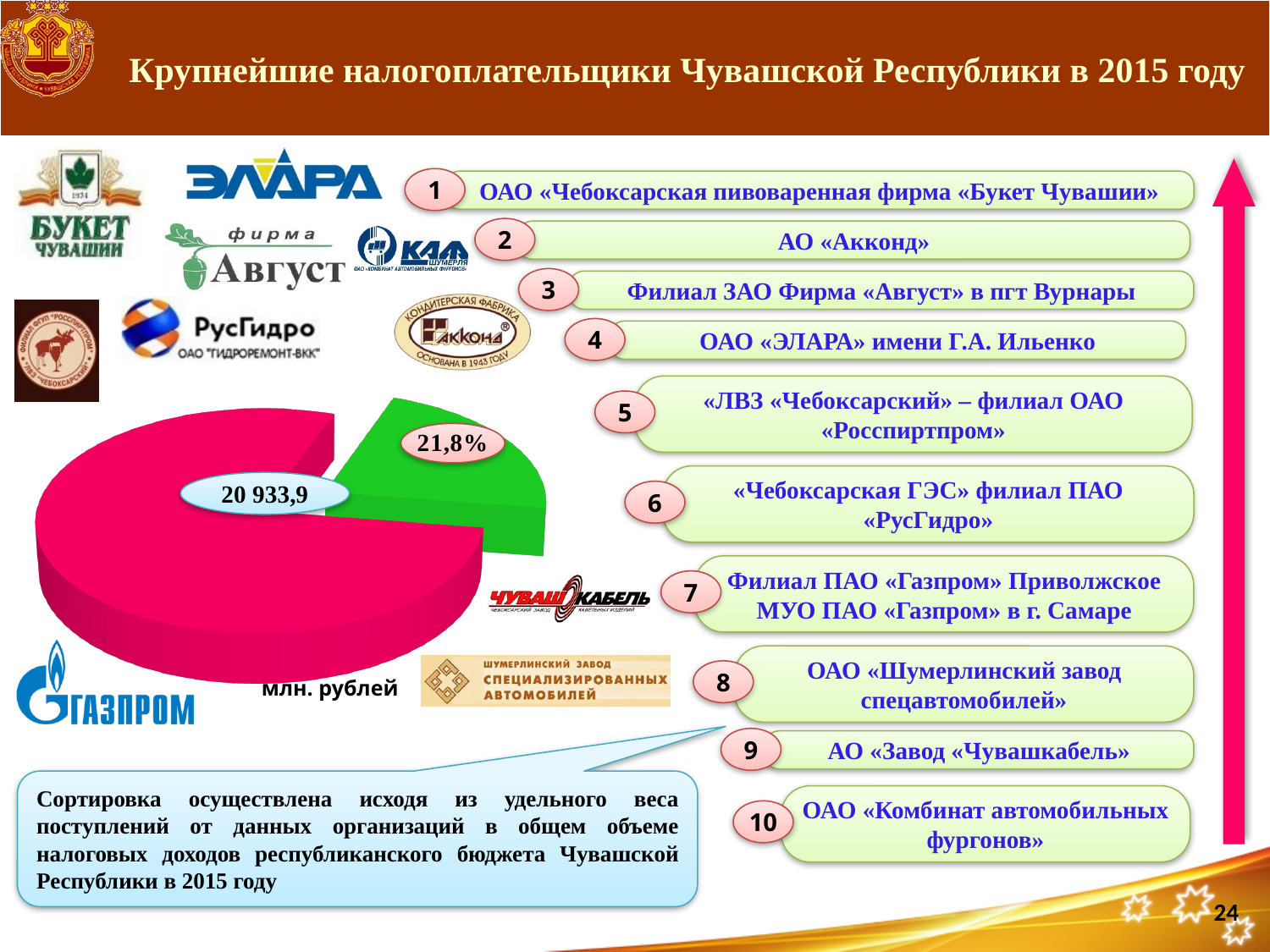
What colour is the largest slice of the pie chart? pink What percentage label is printed on the green slice of the pie chart? 21,8% Is the share of the green slice in the pie chart greater or less than 25%? less What kind of chart is shown on the slide? pie chart How many slices does the pie chart have? 2 Which slice of the pie chart is the smallest? the green slice Which slice of the pie chart is larger, the pink one or the green one? the pink one What value label is printed on the large pink slice of the pie chart? 20 933,9 What unit is shown next to the pie chart for the value 20 933,9? млн. рублей